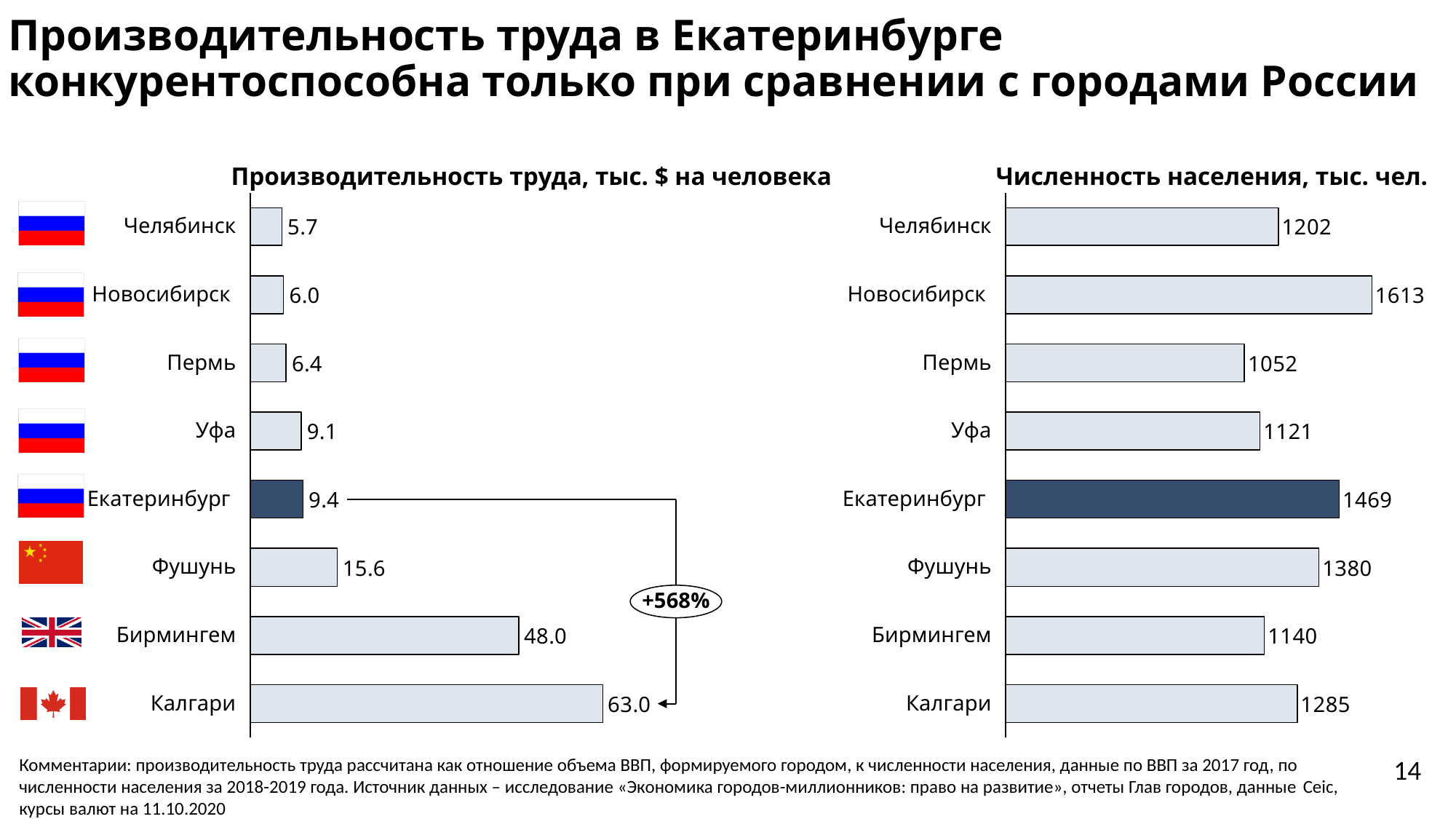
In the chart 'Производительность труда, тыс. $ на человека', which is larger: the value for Фушунь or the value for Уфа? Фушунь How many cities are shown in the chart 'Производительность труда, тыс. $ на человека'? 8 In the chart 'Численность населения, тыс. чел.', which city has the lowest value? Пермь In the chart 'Производительность труда, тыс. $ на человека', what is the value for Екатеринбург? 9.4 In the chart 'Производительность труда, тыс. $ на человека', what percentage is shown in the callout between Екатеринбург and Калгари? +568% In the chart 'Численность населения, тыс. чел.', which city has the highest value? Новосибирск In the chart 'Производительность труда, тыс. $ на человека', which city has the lowest value? Челябинск In the chart 'Производительность труда, тыс. $ на человека', which city has the highest value? Калгари In the chart 'Производительность труда, тыс. $ на человека', what is the difference between the values for Калгари and Екатеринбург? 53.6 What type of chart is 'Численность населения, тыс. чел.'? Bar chart In the chart 'Численность населения, тыс. чел.', what is the difference between the values for Екатеринбург and Фушунь? 89 In the chart 'Численность населения, тыс. чел.', what is the value for Новосибирск? 1613